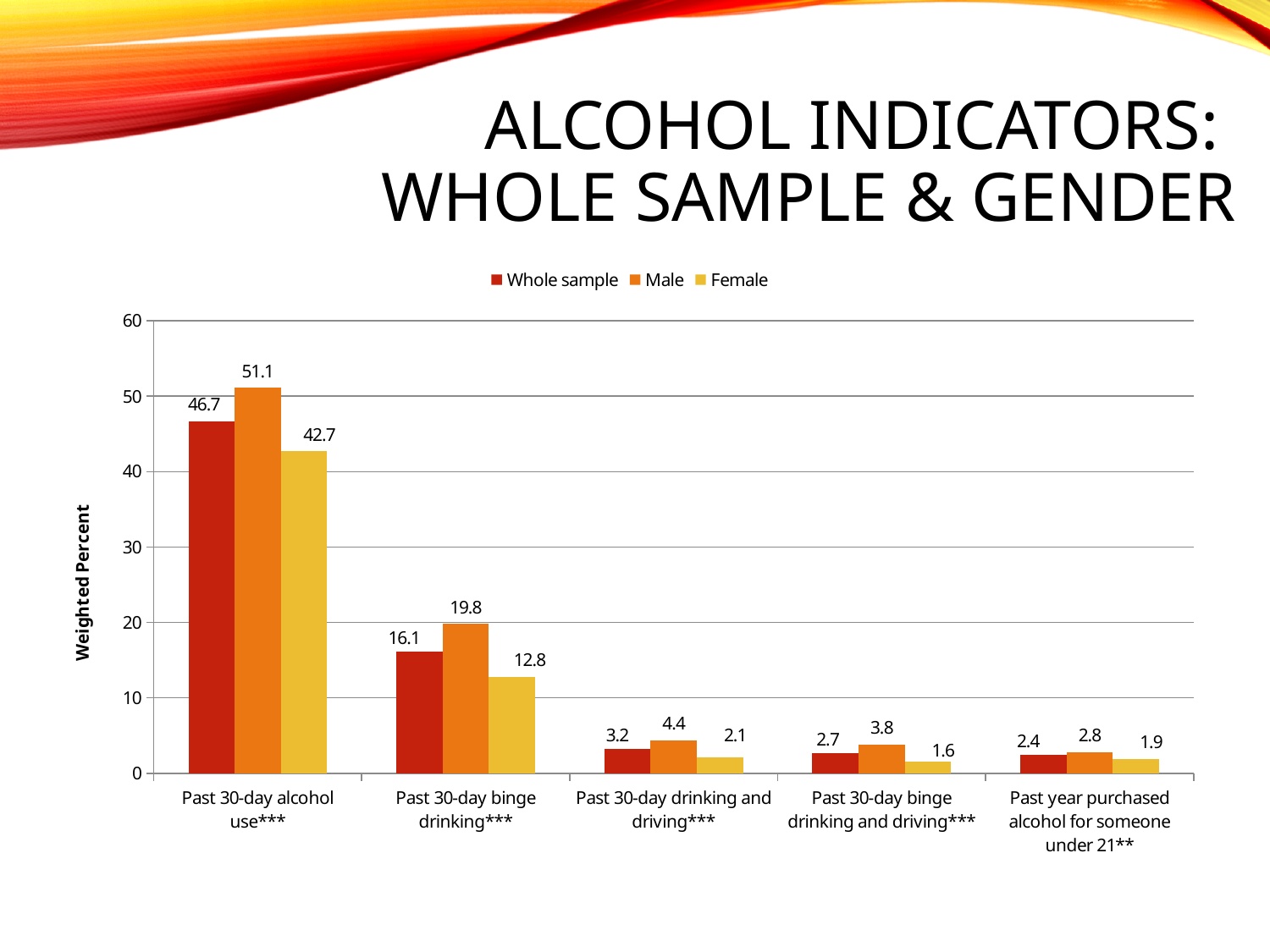
Which category has the lowest Female value? Past 30-day binge drinking and driving Which is larger for Past 30-day drinking and driving: the Male value or the Female value? Male What kind of chart is shown on the slide? bar chart What is the label of the y axis? Weighted Percent What is the Female value for Past 30-day binge drinking? 12.8 Is the Whole sample value for Past 30-day binge drinking greater or less than 20? less Which category has the highest Whole sample value? Past 30-day alcohol use What is the Whole sample value for Past year purchased alcohol for someone under 21? 2.4 How many categories are shown on the x axis? 5 What is the difference between the Male and Female values for Past 30-day alcohol use? 8.4 What is the Male value for Past 30-day alcohol use? 51.1 How many series does the legend list? 3